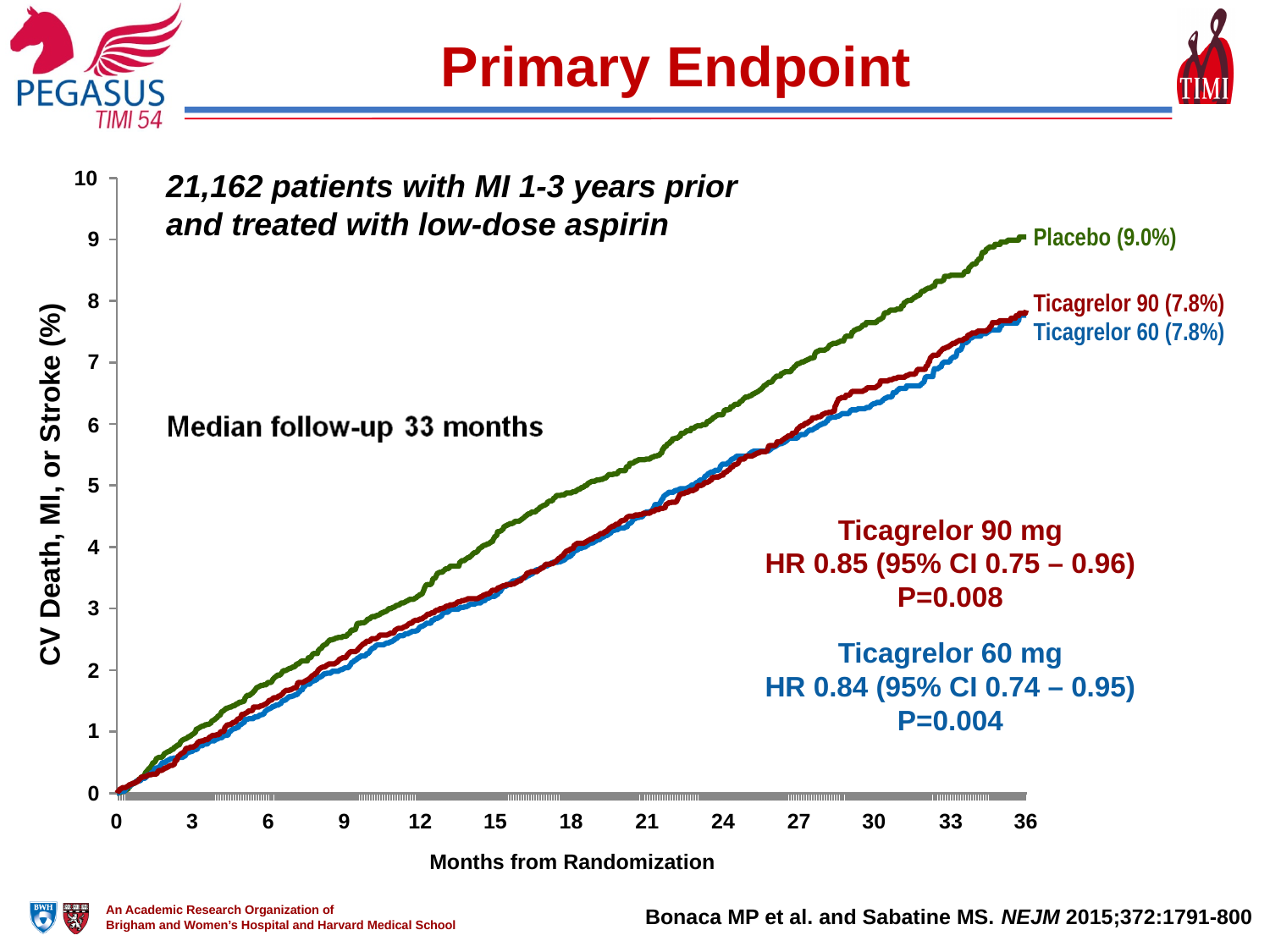
Which is larger at the end of follow-up, the Placebo event rate or the Ticagrelor 60 event rate? Placebo Which group has the highest event rate at the end of follow-up? Placebo What is the difference between the final event rates of Placebo and Ticagrelor 90? 1.2% What is the final event rate shown for the Placebo group? 9.0% Is the value for Ticagrelor 60 at 24 months greater or less than 5? greater What is the final event rate shown for the Ticagrelor 60 group? 7.8% What kind of chart is shown on the slide? Line chart Is the value for Placebo at 30 months greater or less than 7? greater How many treatment groups (series) are plotted on the chart? 3 What is the label of the y axis? CV Death, MI, or Stroke (%) What is the final event rate shown for the Ticagrelor 90 group? 7.8% Do the event rates rise or fall as months from randomization increase? Rise